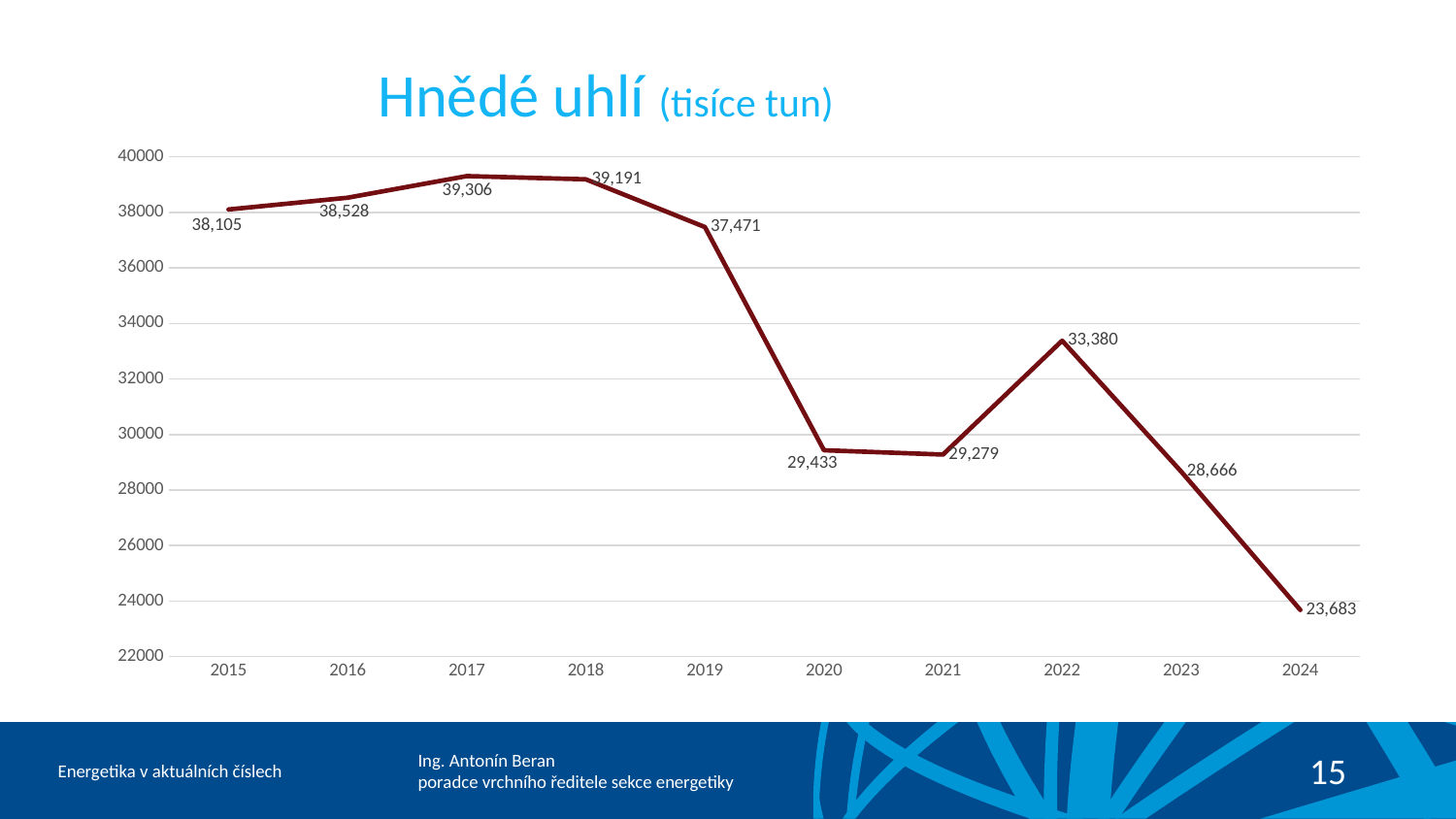
How many years are plotted on the chart? 10 Is the value for 2021 greater or less than 30000? less Which is larger, the value for 2019 or the value for 2022? 2019 Which year has the lowest value? 2024 What kind of chart is shown? line chart What is the value for 2020? 29,433 What is the difference between the values for 2015 and 2024? 14,422 What is the value for 2017? 39,306 Which year has the highest value? 2017 What is the difference between the values for 2022 and 2023? 4,714 What is the value for 2024? 23,683 What is the title of the chart? Hnědé uhlí (tisíce tun)